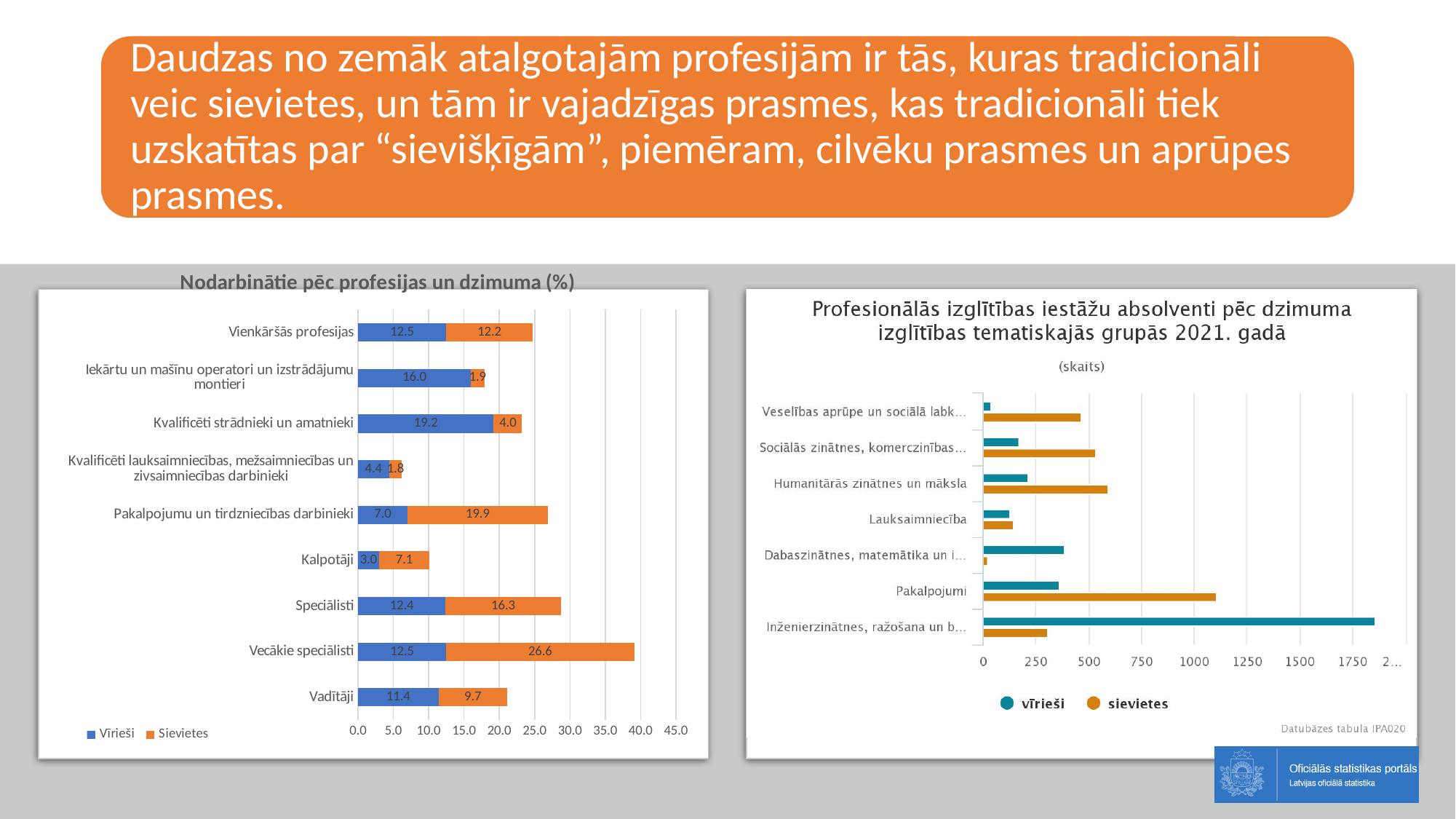
In the chart 'Nodarbinātie pēc profesijas un dzimuma (%)', what is the value for Sievietes in the category Vecākie speciālisti? 26.6 In the chart 'Nodarbinātie pēc profesijas un dzimuma (%)', which category has the lowest Vīrieši value? Kalpotāji In the chart 'Nodarbinātie pēc profesijas un dzimuma (%)', what is the value for Vīrieši in the category Kvalificēti strādnieki un amatnieki? 19.2 In the chart 'Nodarbinātie pēc profesijas un dzimuma (%)', which category has the highest Sievietes value? Vecākie speciālisti What kind of chart is the right-hand chart 'Profesionālās izglītības iestāžu absolventi pēc dzimuma izglītības tematiskajās grupās 2021. gadā'? Bar chart In the chart 'Nodarbinātie pēc profesijas un dzimuma (%)', what is the total of the stacked bar for Speciālisti? 28.7 How many series does the legend list in the right-hand chart 'Profesionālās izglītības iestāžu absolventi pēc dzimuma izglītības tematiskajās grupās 2021. gadā'? 2 In the chart 'Nodarbinātie pēc profesijas un dzimuma (%)', what is the difference between the Sievietes and Vīrieši values for Pakalpojumu un tirdzniecības darbinieki? 12.9 In the right-hand chart 'Profesionālās izglītības iestāžu absolventi pēc dzimuma izglītības tematiskajās grupās 2021. gadā', is the value for vīrieši in Inženierzinātnes, ražošana un b... greater or less than 1750? greater How many categories are shown in the chart 'Nodarbinātie pēc profesijas un dzimuma (%)'? 9 In the chart 'Nodarbinātie pēc profesijas un dzimuma (%)', which is larger for Vadītāji: the Vīrieši value or the Sievietes value? Vīrieši In the right-hand chart 'Profesionālās izglītības iestāžu absolventi pēc dzimuma izglītības tematiskajās grupās 2021. gadā', is the value for sievietes in Pakalpojumi greater or less than 1000? greater